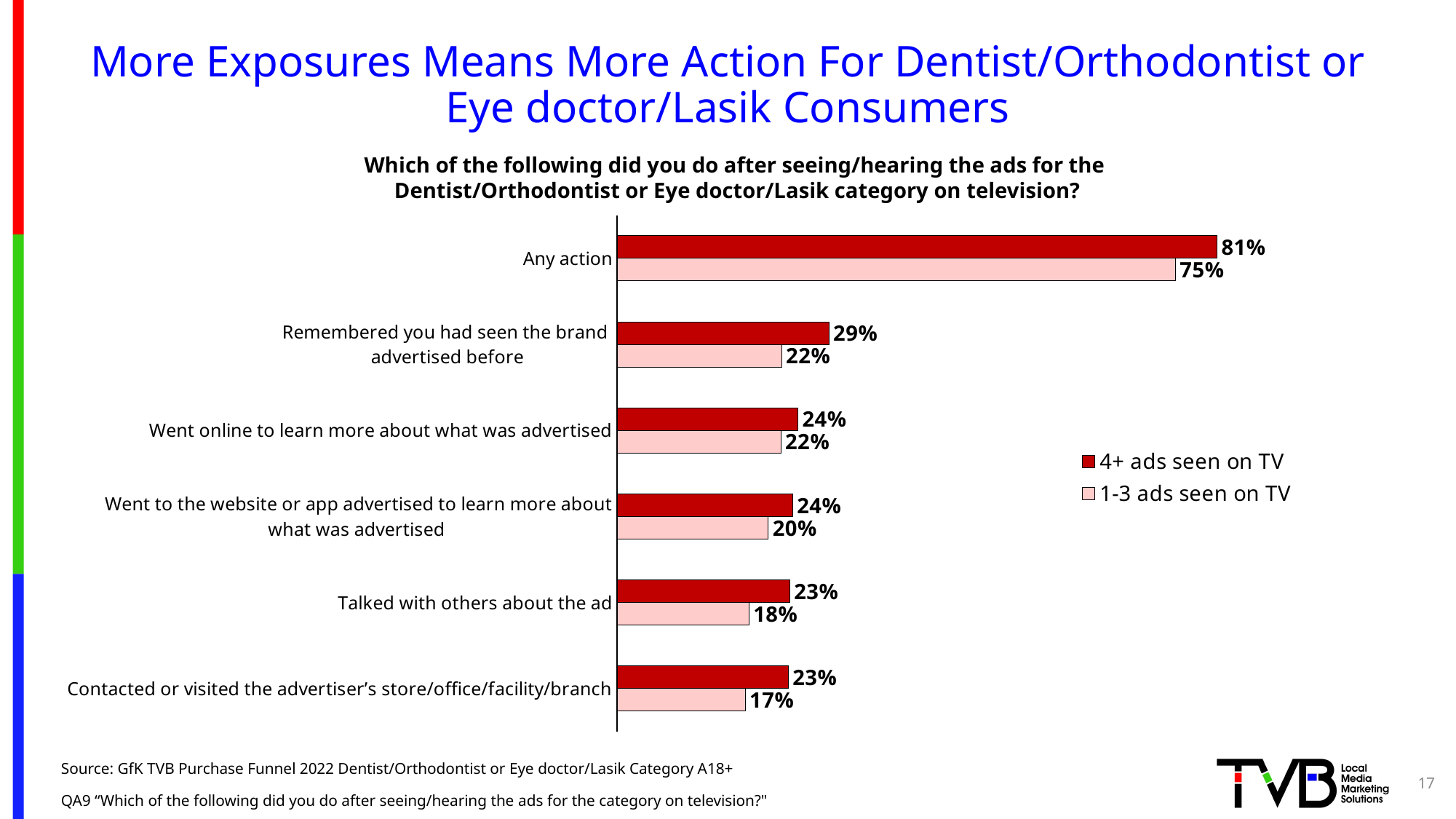
Which category has the highest value for the 4+ ads seen on TV series? Any action Which colour represents the '4+ ads seen on TV' series? Dark red What percentage of consumers who saw 4+ ads on TV took any action? 81% What is the difference between the 4+ ads and 1-3 ads values for 'Remembered you had seen the brand advertised before'? 7 percentage points What is the difference between the 4+ ads and 1-3 ads values for 'Any action'? 6 percentage points What percentage of consumers who saw 1-3 ads on TV remembered they had seen the brand advertised before? 22% How many action categories are shown in the chart? 6 What is the value for 'Talked with others about the ad' among those who saw 1-3 ads on TV? 18% What type of chart is shown on the slide? Bar chart Which category has the lowest value for the 1-3 ads seen on TV series? Contacted or visited the advertiser's store/office/facility/branch How many series does the legend list? 2 For 'Contacted or visited the advertiser's store/office/facility/branch', which group has the larger value: 4+ ads seen on TV or 1-3 ads seen on TV? 4+ ads seen on TV